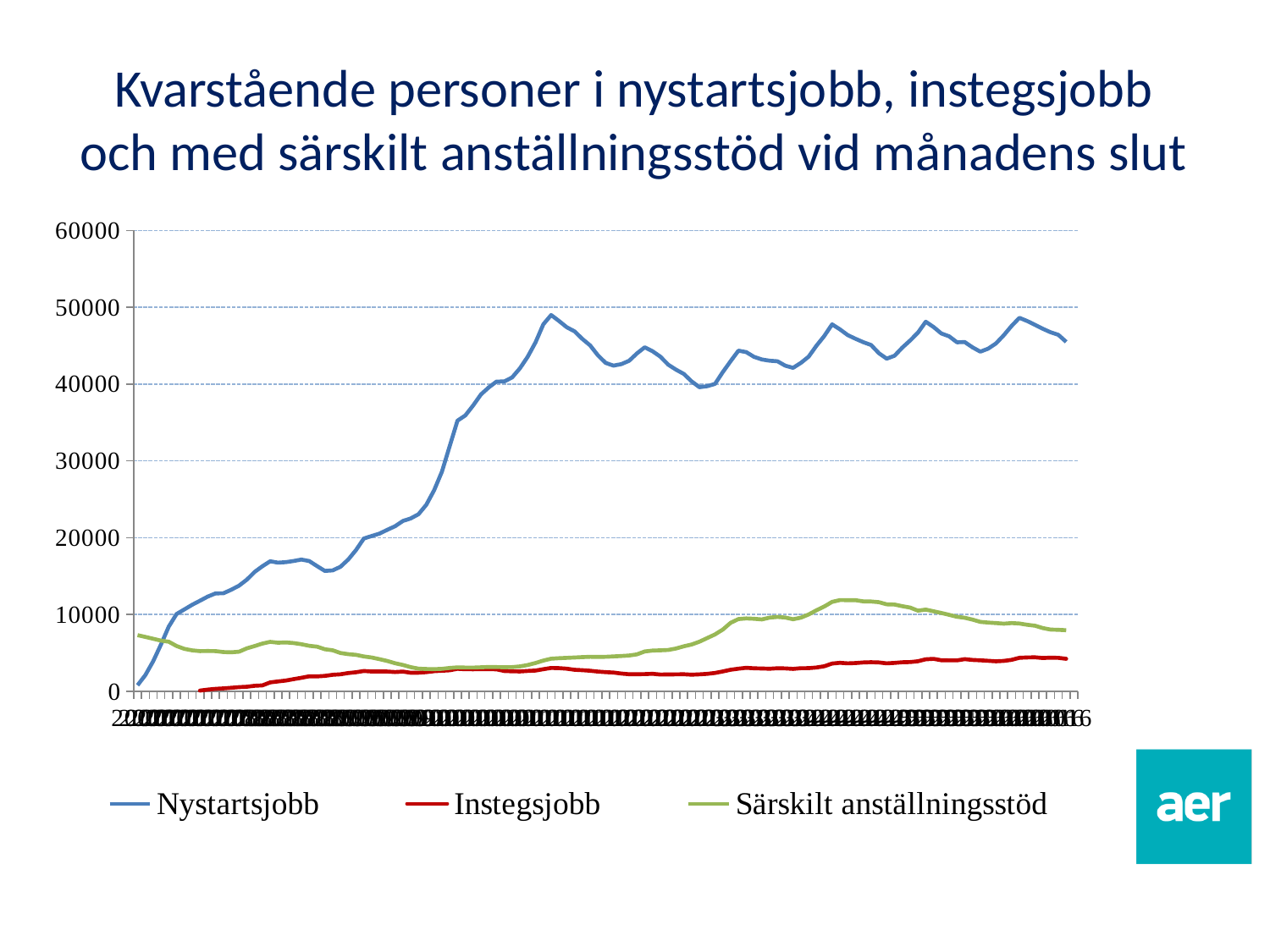
At the end of the period, which series is higher: Nystartsjobb or Särskilt anställningsstöd? Nystartsjobb Does the Nystartsjobb series overall rise or fall from the start to the end of the period? rise How many series does the legend list? 3 What kind of chart is shown on the slide? line chart What are the three series named in the legend? Nystartsjobb, Instegsjobb, Särskilt anställningsstöd Is the highest value reached by Särskilt anställningsstöd greater or less than 10000? greater Is the value for Nystartsjobb at the end of the period greater or less than 40000? greater What is the title of the chart? Kvarstående personer i nystartsjobb, instegsjobb och med särskilt anställningsstöd vid månadens slut Which series has the lowest values at the end of the period? Instegsjobb Which series reaches the highest values on the chart? Nystartsjobb Is the highest value reached by Nystartsjobb greater or less than 50000? less At the start of the period, which series is higher: Nystartsjobb or Särskilt anställningsstöd? Särskilt anställningsstöd